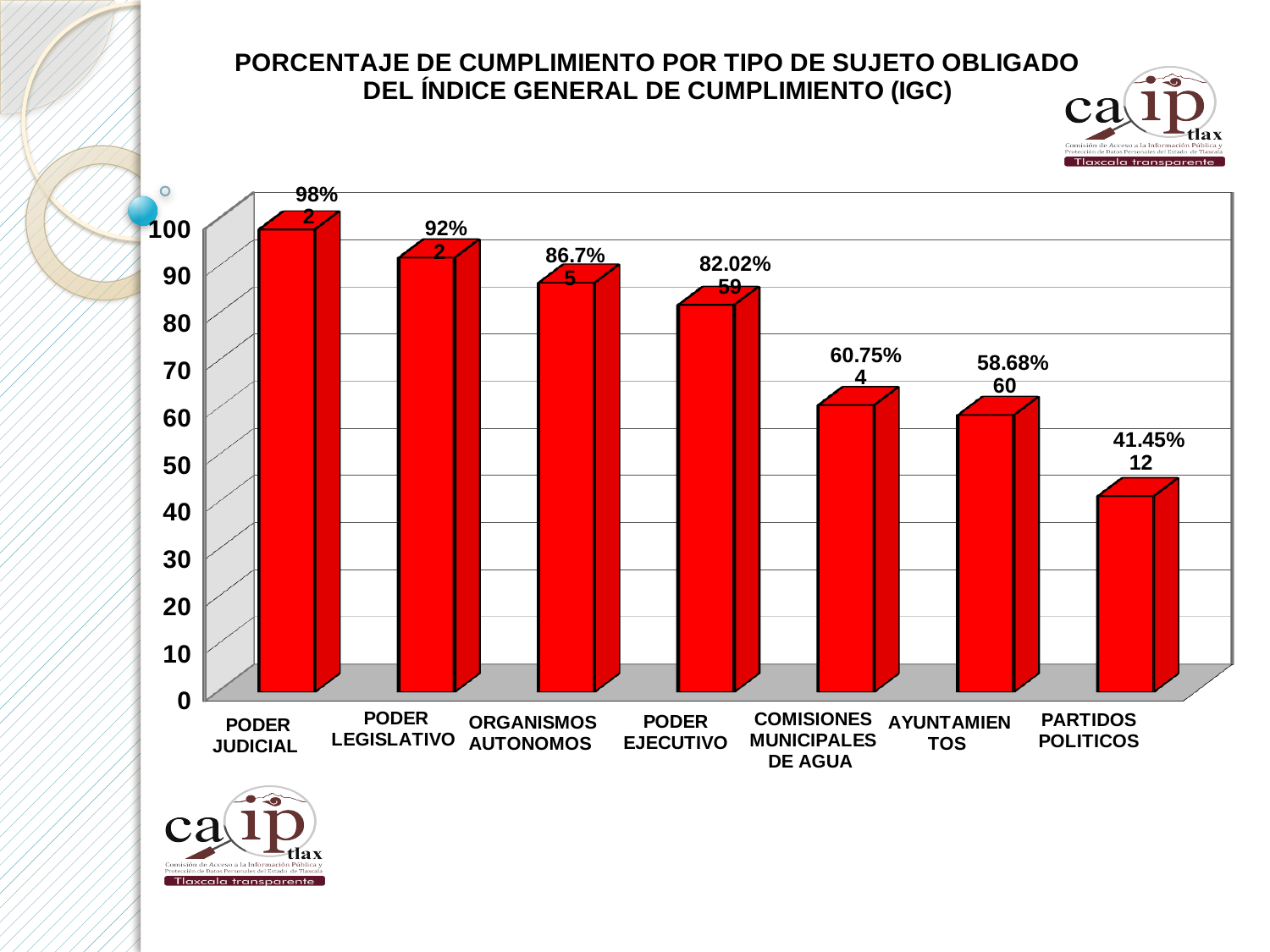
How many categories (types of obligated subject) are shown on the chart? 7 Which category has the lowest compliance percentage? PARTIDOS POLITICOS Is the value for AYUNTAMIENTOS greater or less than 70? less What is the compliance percentage shown for PODER JUDICIAL? 98% What is the difference in percentage points between PODER JUDICIAL (98%) and PODER LEGISLATIVO (92%)? 6 What is the compliance percentage shown for PODER EJECUTIVO? 82.02% What is the compliance percentage shown for COMISIONES MUNICIPALES DE AGUA? 60.75% Which category has the highest compliance percentage? PODER JUDICIAL Which has a higher compliance percentage, ORGANISMOS AUTONOMOS or AYUNTAMIENTOS? ORGANISMOS AUTONOMOS What kind of chart is shown on the slide? bar chart Do the values rise or fall moving from left to right along the x axis? fall What is the compliance percentage shown for PARTIDOS POLITICOS? 41.45%